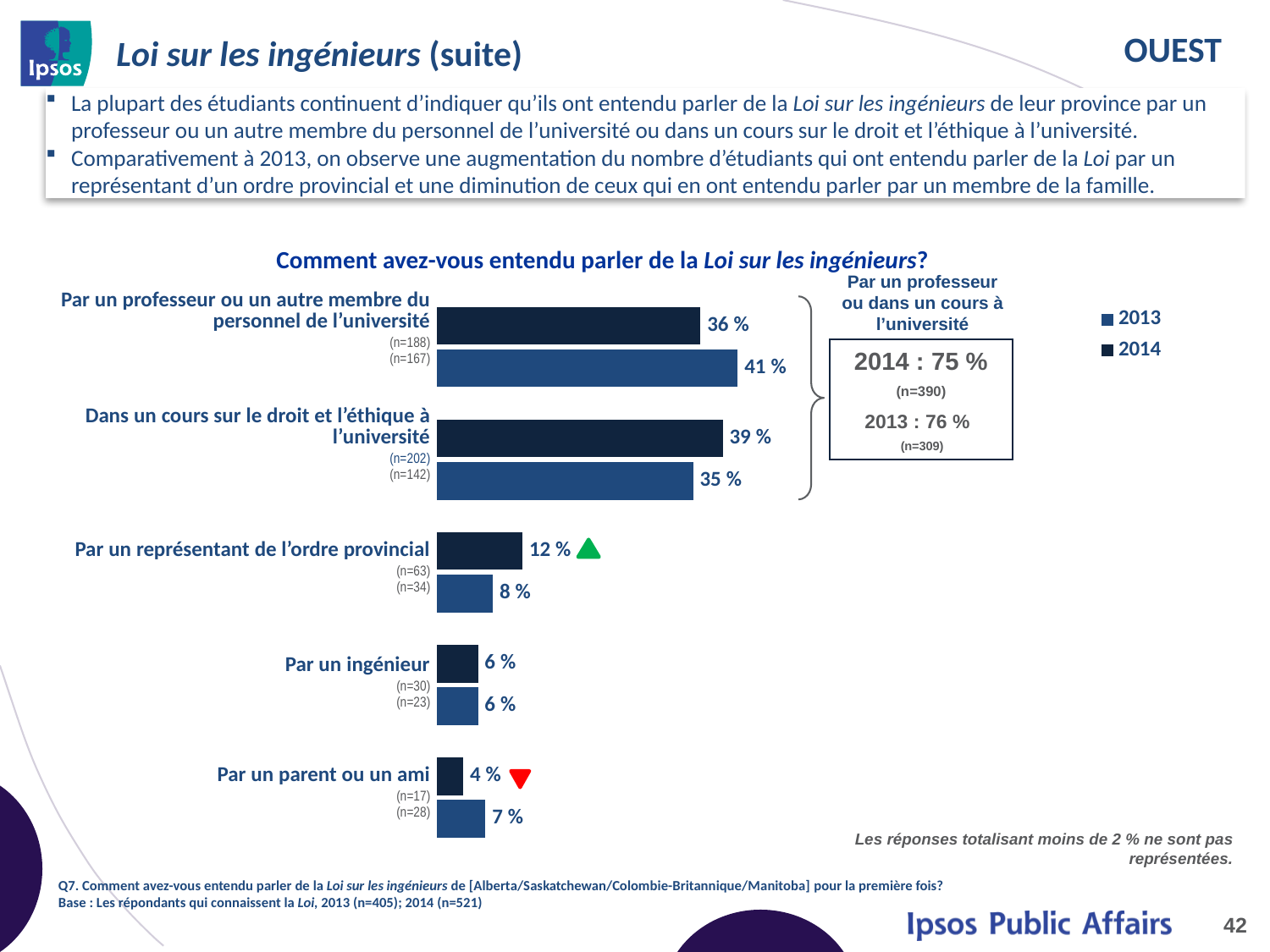
What kind of chart is shown on the slide? bar chart What is the difference between the two bars for 'Par un professeur ou un autre membre du personnel de l'université' (41 % and 36 %)? 5 percentage points In the summary box 'Par un professeur ou dans un cours à l'université', what is the value for 2013? 76 % In the summary box 'Par un professeur ou dans un cours à l'université', what is the value for 2014? 75 % What are the two values shown for 'Par un ingénieur'? 6 % and 6 % For 'Par un parent ou un ami', which of the two bars is larger, the one labelled 4 % or the one labelled 7 %? 7 % How many series does the chart legend list? 2 Which years are listed in the chart legend? 2013 and 2014 What is the lowest value shown on any bar in the chart? 4 % What are the two values shown for 'Par un représentant de l'ordre provincial'? 12 % and 8 % How many response categories are plotted in the chart? 5 What is the highest value shown on any bar in the chart? 41 %